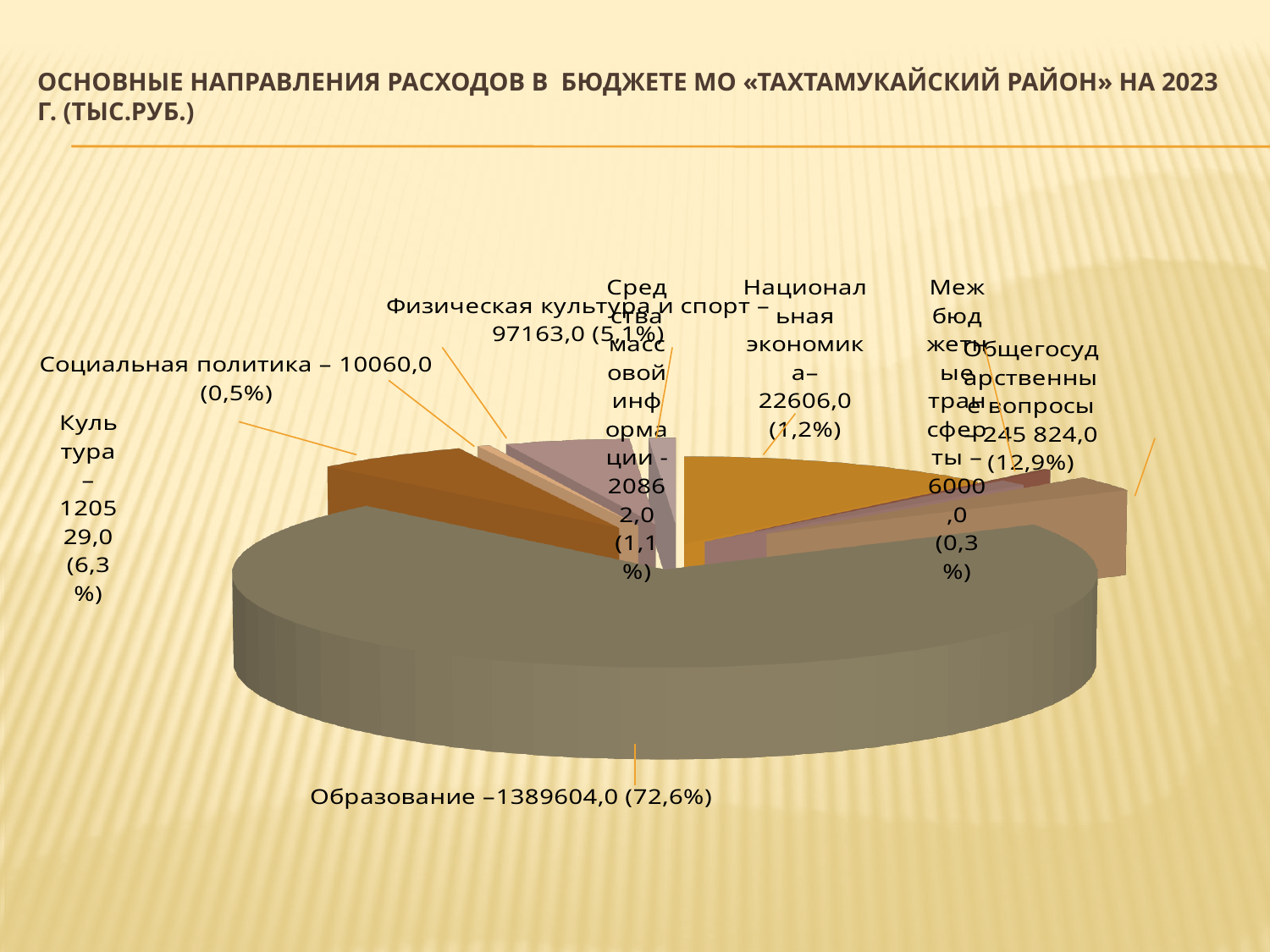
Which is larger, Национальная экономика or Средства массовой информации? Национальная экономика How many categories (slices) does the pie chart show? 9 What share of the pie does Культура take? 6,3% What is the value for Образование? 1389604,0 Which category has the smallest slice? Межбюджетные трансферты What share of the pie does Образование take? 72,6% What unit is stated in the chart title for the values? тыс.руб. What is the value for Общегосударственные вопросы? 245 824,0 What kind of chart is shown on the slide? pie chart Which category has the largest slice? Образование What is the difference between the values for Социальная политика and Межбюджетные трансферты? 4060,0 What is the value for Физическая культура и спорт? 97163,0